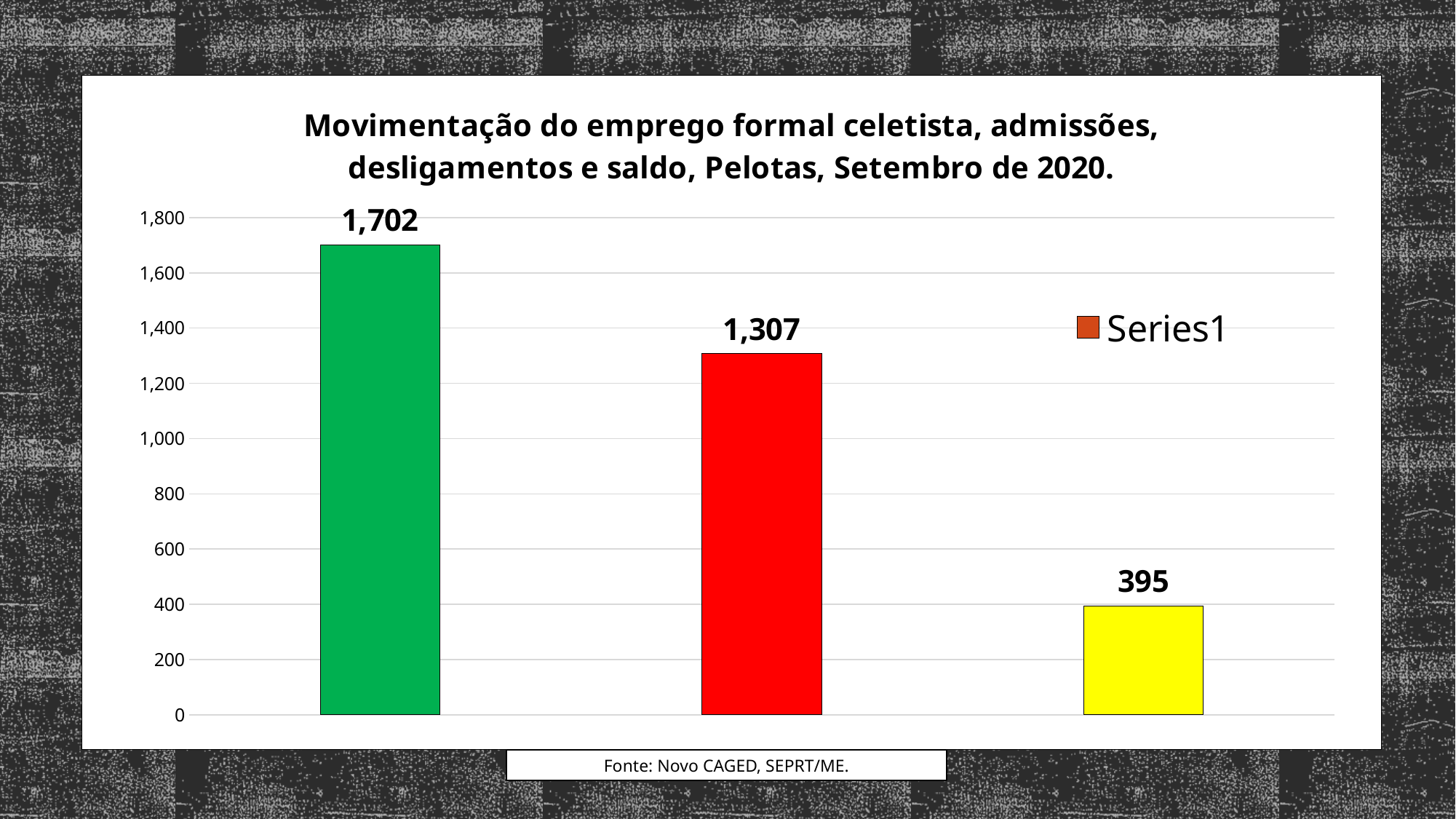
How many series does the legend list? 1 What is the value shown on the yellow bar (the rightmost bar)? 395 Which bar has the lowest value? The yellow bar (rightmost), 395 Do the bar values rise or fall from left to right? Fall Which is larger, the value of the red bar or the value of the yellow bar? The red bar What is the difference between the red bar's value and the yellow bar's value? 912 What is the difference between the green bar's value and the red bar's value? 395 How many bars are plotted in the chart? 3 What kind of chart is shown on the slide? Bar chart What is the value shown on the green bar (the first bar from the left)? 1,702 Which bar has the highest value? The green bar (first from the left), 1,702 What is the value shown on the red bar (the middle bar)? 1,307